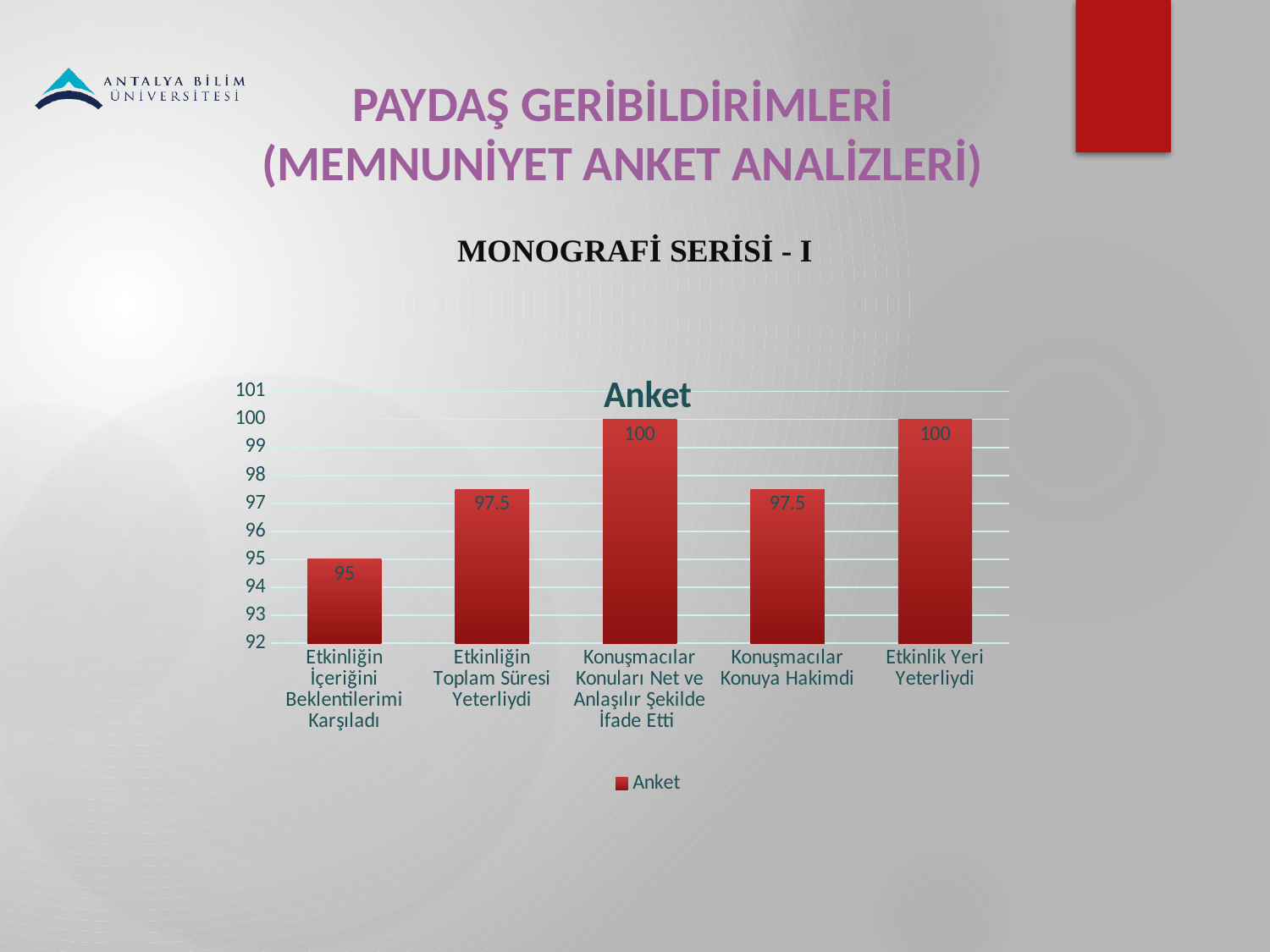
Is the value for "Etkinliğin Toplam Süresi Yeterliydi" greater or less than 96? greater How many series does the legend list? 1 How many categories are shown on the x axis? 5 Which is larger: the value for "Konuşmacılar Konuya Hakimdi" or the value for "Etkinliğin İçeriğini Beklentilerimi Karşıladı"? Konuşmacılar Konuya Hakimdi What is the value for "Etkinliğin İçeriğini Beklentilerimi Karşıladı"? 95 What is the value for "Etkinlik Yeri Yeterliydi"? 100 What is the value for "Etkinliğin Toplam Süresi Yeterliydi"? 97.5 Which category has the lowest value? Etkinliğin İçeriğini Beklentilerimi Karşıladı What is the difference between the values for "Etkinlik Yeri Yeterliydi" and "Etkinliğin İçeriğini Beklentilerimi Karşıladı"? 5 What is the difference between the values for "Konuşmacılar Konuları Net ve Anlaşılır Şekilde İfade Etti" and "Konuşmacılar Konuya Hakimdi"? 2.5 What kind of chart is shown? bar chart What is the title of the chart? Anket